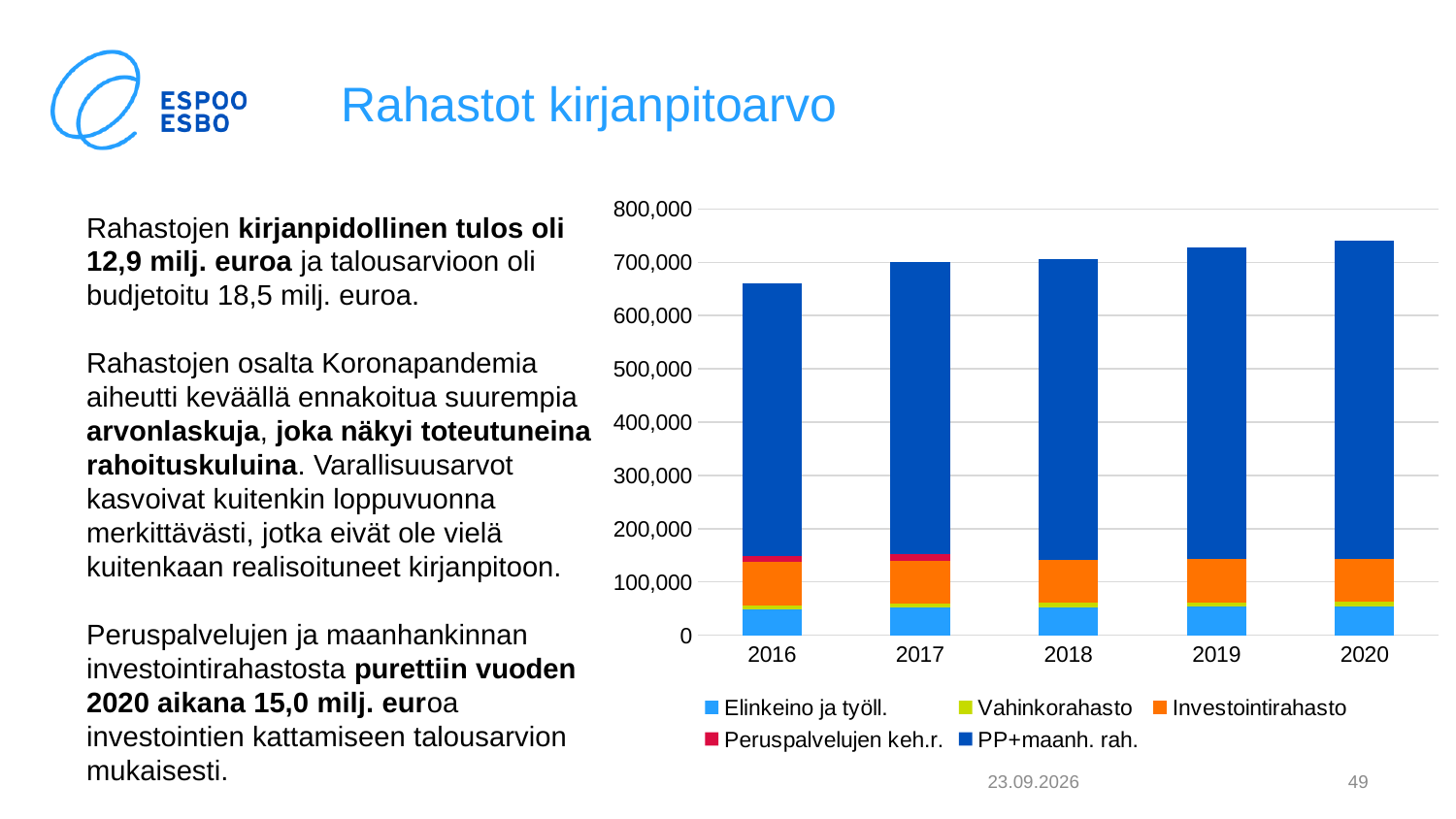
Is the total bar for 2016 greater or less than 700,000? less Which year has the larger total bar, 2016 or 2017? 2017 What is the title of the slide containing the chart? Rahastot kirjanpitoarvo Do the total bar heights rise or fall from 2016 to 2020? Rise Which year has the highest total bar in the chart? 2020 What kind of chart is shown on the slide? Stacked bar chart Which year has the lowest total bar in the chart? 2016 Is the total bar for 2016 greater or less than 600,000? greater Is the total bar for 2020 greater or less than 700,000? greater Which series in the legend is shown in dark blue? PP+maanh. rah. How many series does the chart legend list? 5 How many years are shown on the x axis of the chart? 5